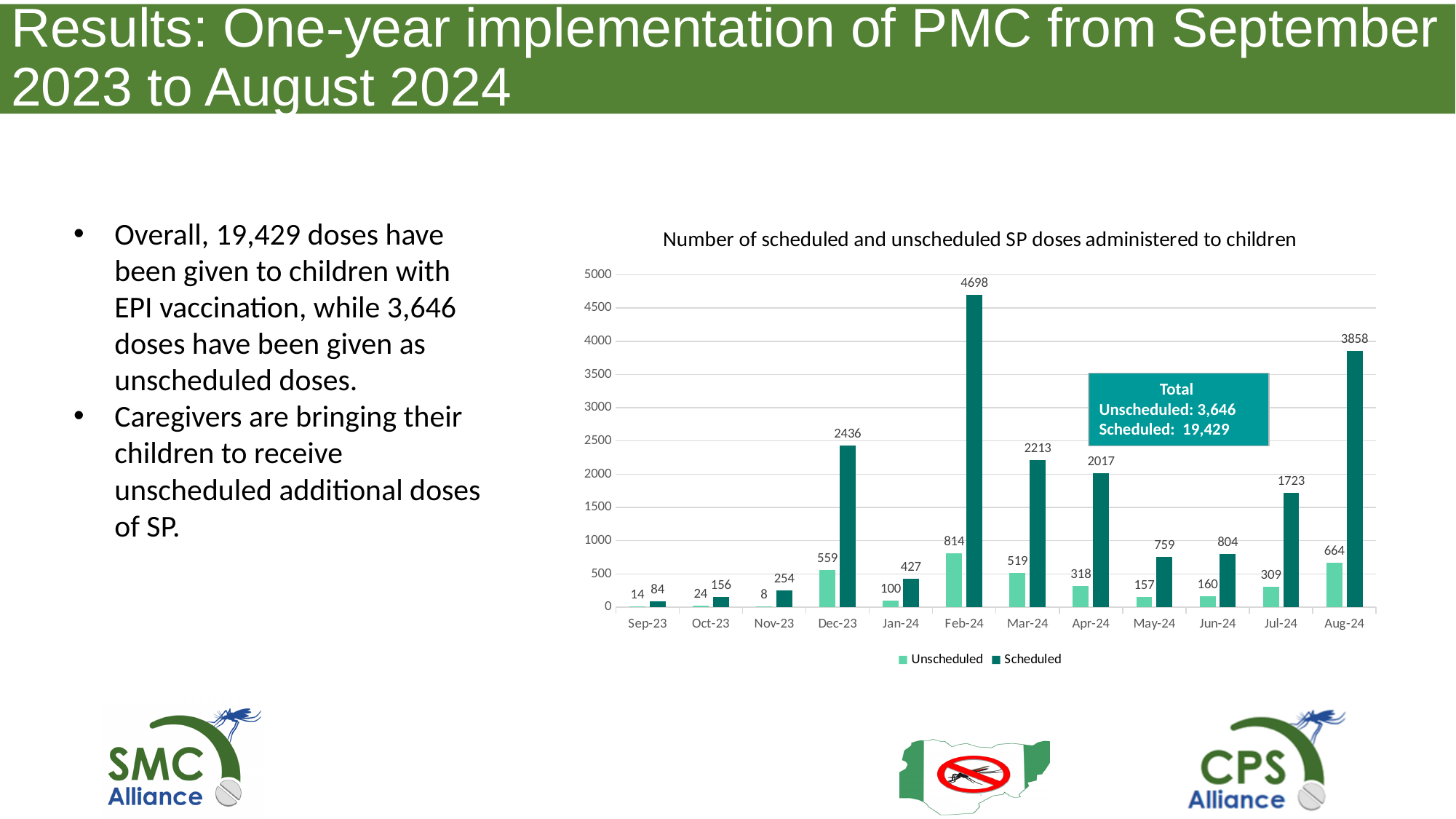
Which month has the lowest number of unscheduled doses? Nov-23 Do the scheduled doses rise or fall from Sep-23 to Feb-24? Rise Which month has the highest number of scheduled doses? Feb-24 How many months are shown on the x axis of the chart? 12 Which is larger, the scheduled doses in Mar-24 or in Apr-24? Mar-24 What kind of chart is shown on the slide? Bar chart What is the title of the chart? Number of scheduled and unscheduled SP doses administered to children How many series does the chart legend list? 2 What is the number of unscheduled SP doses administered in Dec-23? 559 What is the number of scheduled SP doses administered in Feb-24? 4698 What is the difference between scheduled and unscheduled doses in Aug-24? 3194 Is the value for scheduled doses in Jul-24 greater or less than 1500? greater